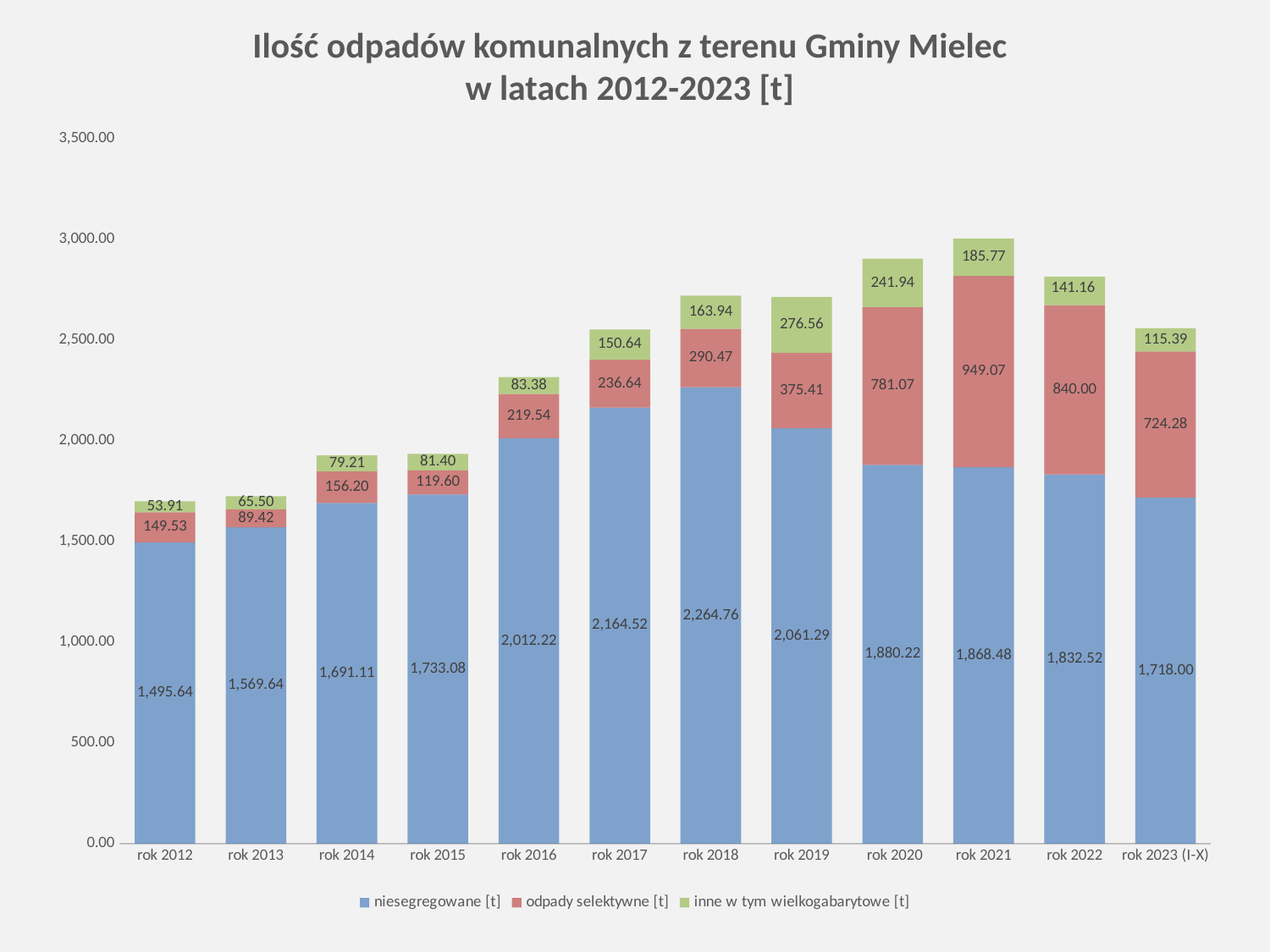
Does the niesegregowane [t] value rise or fall from rok 2018 to rok 2023 (I-X)? Fall How many year categories are shown on the x axis? 12 What is the value of inne w tym wielkogabarytowe [t] for rok 2023 (I-X)? 115.39 What is the value of niesegregowane [t] for rok 2018? 2,264.76 Which is larger, the odpady selektywne [t] value for rok 2020 or for rok 2022? rok 2022 What is the difference between the odpady selektywne [t] values for rok 2021 and rok 2020? 168.00 What type of chart is shown on the slide? Stacked bar chart Which year has the highest value for niesegregowane [t]? rok 2018 What is the value of odpady selektywne [t] for rok 2021? 949.07 Which year has the lowest value for inne w tym wielkogabarytowe [t]? rok 2012 What is the total of the stacked bar for rok 2012? 1,699.08 How many series does the legend list? 3